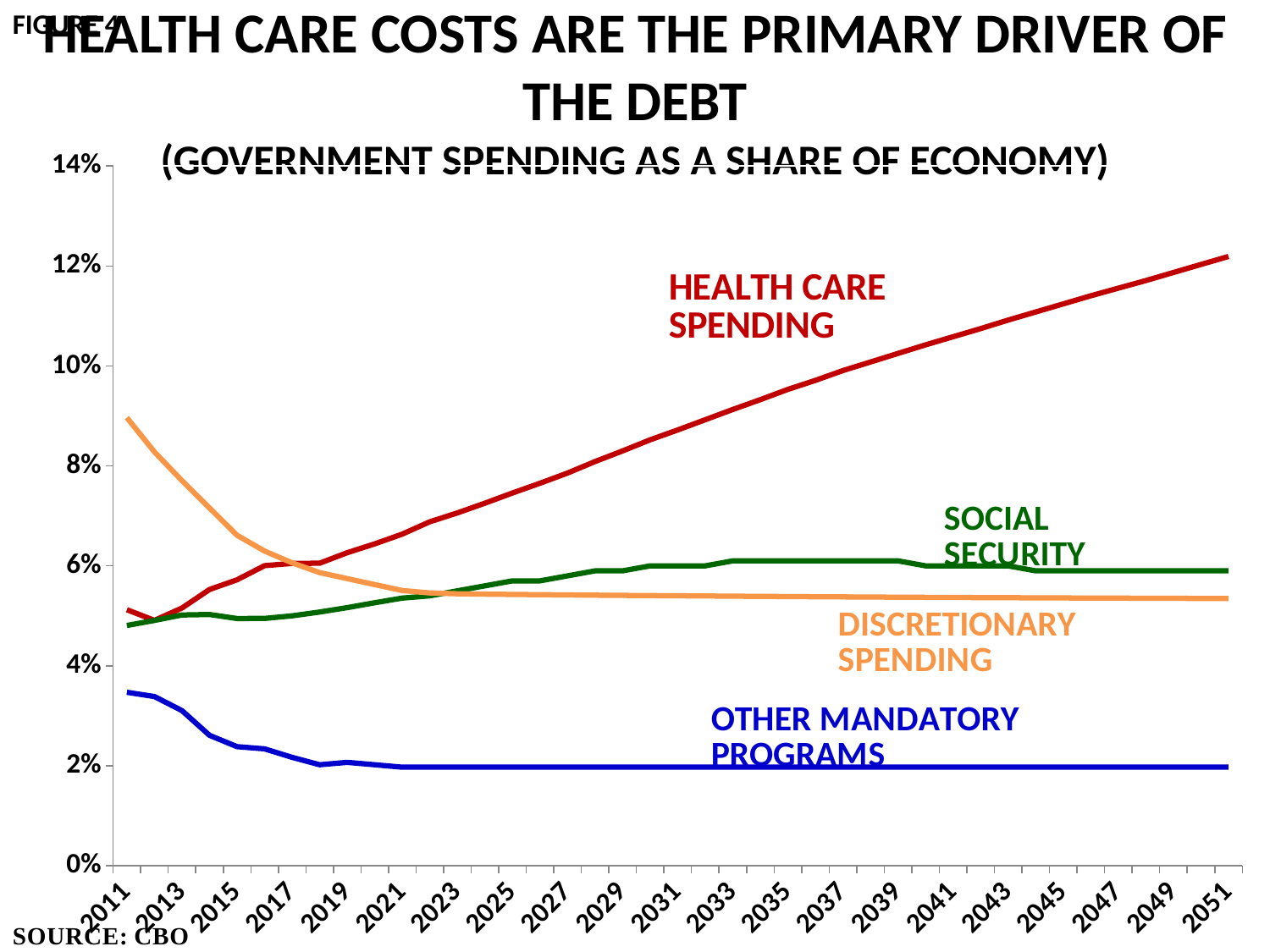
What colour is the Health Care Spending line? red Is the value for Social Security in 2051 greater or less than 8%? less Is the value for Other Mandatory Programs in 2051 greater or less than 4%? less In 2011, which is larger: Discretionary Spending or Health Care Spending? Discretionary Spending Is the value for Discretionary Spending in 2011 greater or less than 8%? greater What kind of chart is shown on the slide? line chart Which spending category has the lowest value in 2051? Other Mandatory Programs Does Health Care Spending rise or fall from 2011 to 2051? rises How many spending categories are plotted as lines on the chart? 4 Does Discretionary Spending rise or fall from 2011 to 2051? falls Which spending category has the highest value in 2051? Health Care Spending